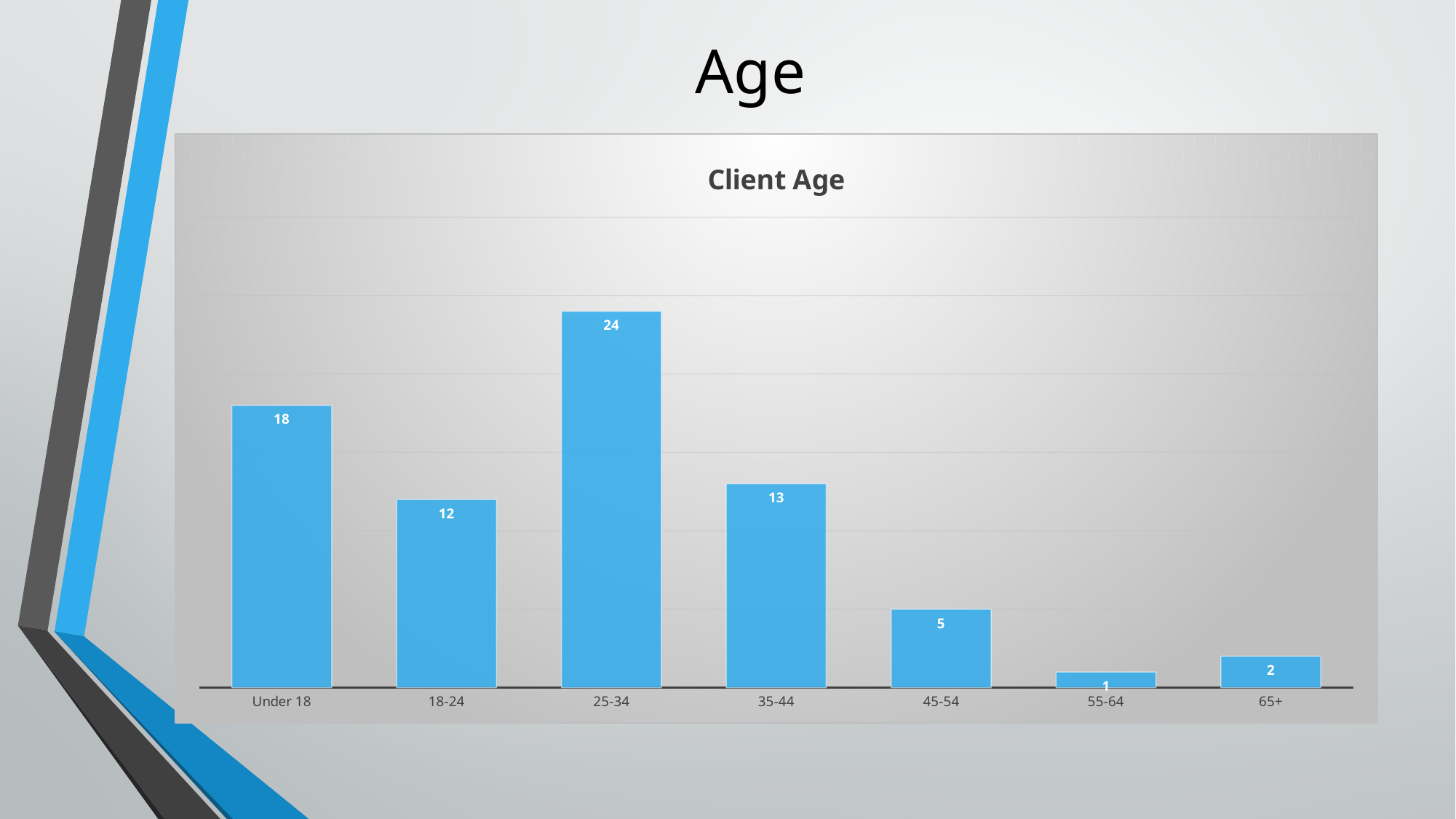
What kind of chart is shown? Bar chart What is the value for the Under 18 age group? 18 Do the values rise or fall from 35-44 to 55-64? Fall What is the difference between the values for Under 18 and 18-24? 6 What is the value for the 25-34 age group? 24 How many age groups are shown on the chart? 7 Which age group has the highest value? 25-34 What is the title of the chart? Client Age What is the value for the 45-54 age group? 5 Which age group has the lowest value? 55-64 What is the difference between the values for 25-34 and 35-44? 11 Which is larger, the value for 18-24 or the value for 35-44? 35-44